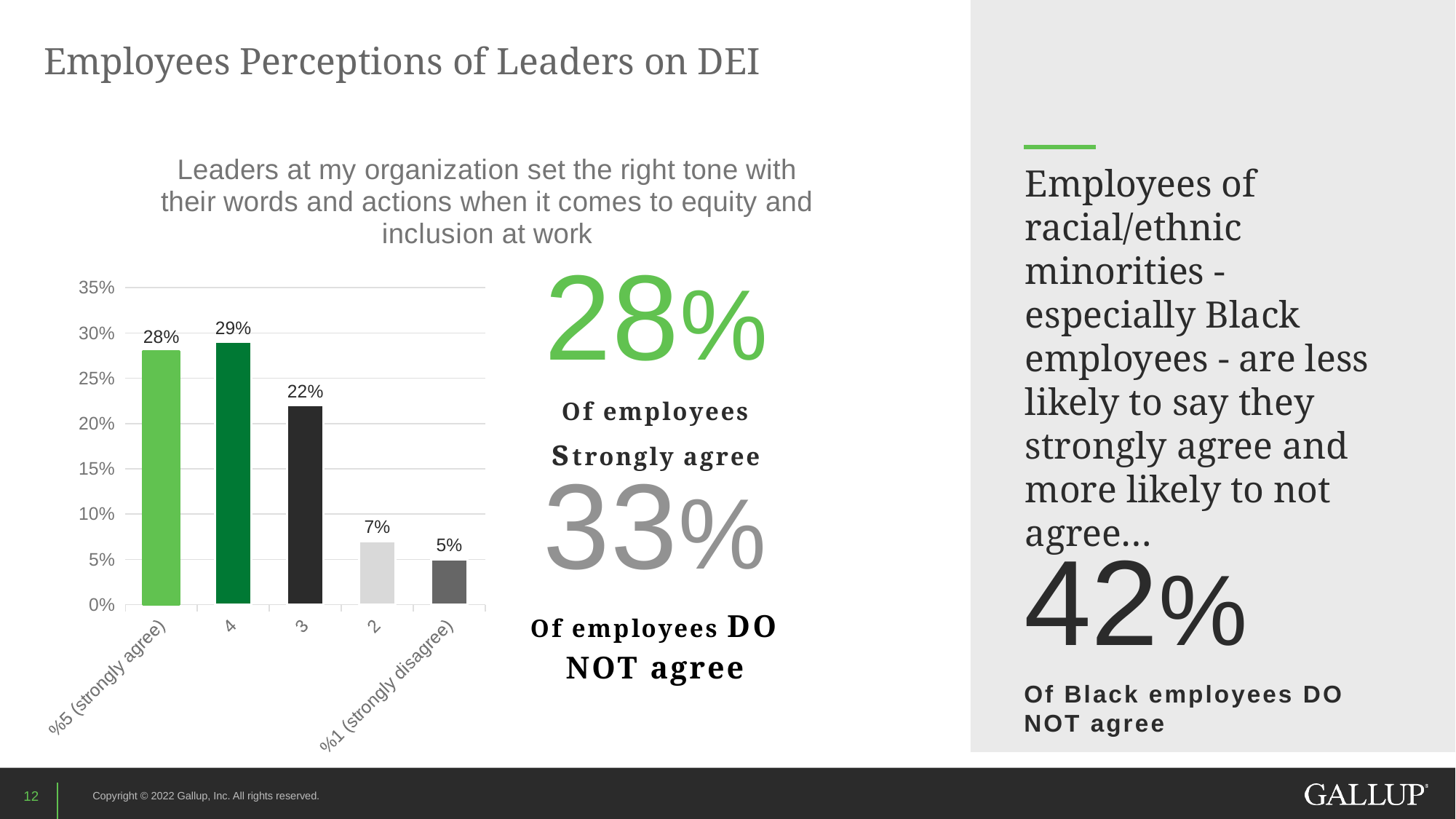
What is the value for the '5 (strongly agree)' category? 28% What is the value for category '2'? 7% Which category has the lowest value? 1 (strongly disagree) What is the value for category '3'? 22% What is the value for the '1 (strongly disagree)' category? 5% Which is larger, the value for category '3' or the value for category '2'? 3 What is the difference between the values for category '3' and category '2'? 15% What is the value for category '4'? 29% How many categories are shown on the x axis? 5 Which category has the highest value? 4 Do the values generally rise or fall moving from category '4' to '1 (strongly disagree)' along the x axis? Fall What kind of chart is shown? Bar chart